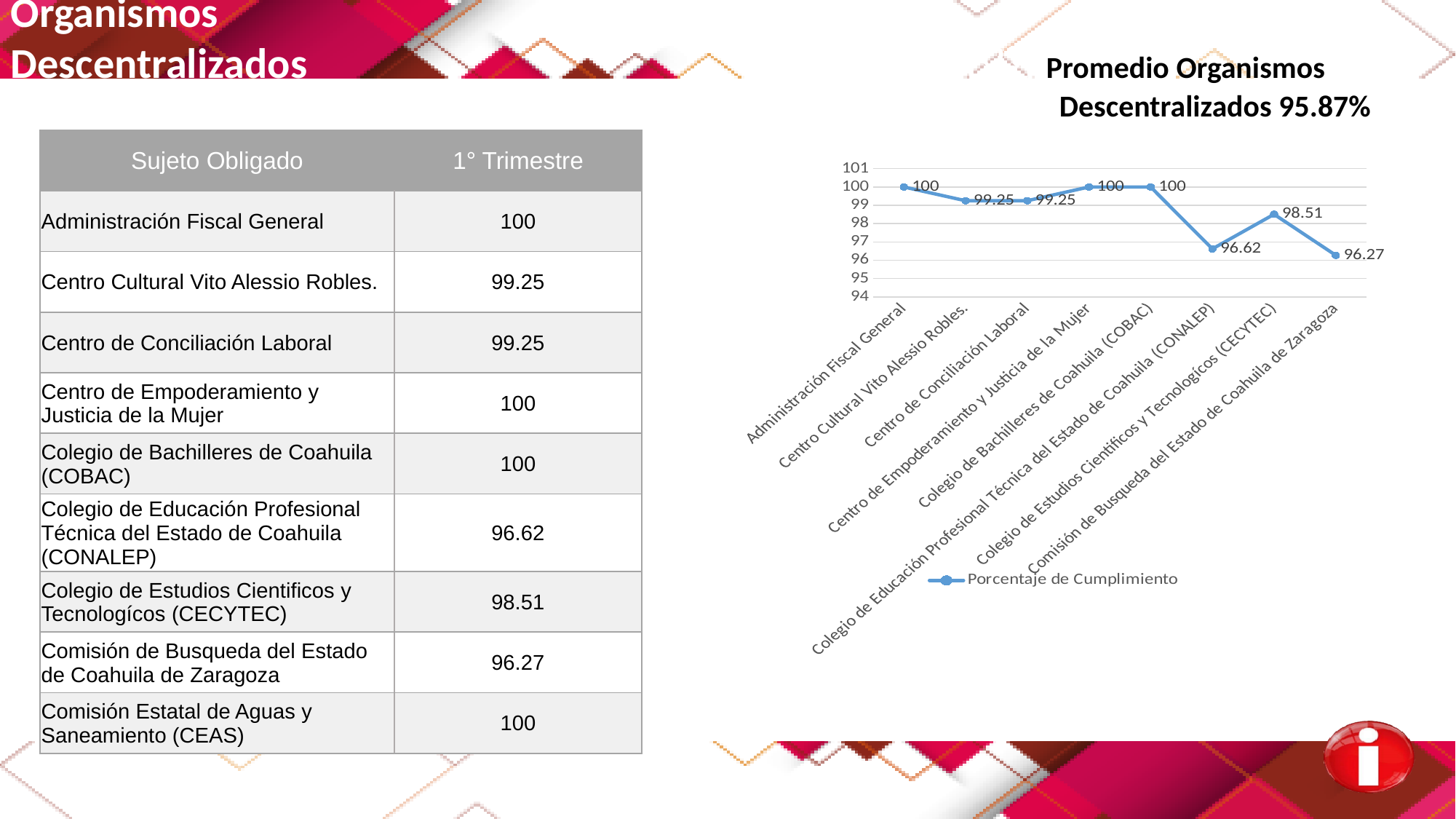
Is the value for CONALEP greater or less than 98? less What kind of chart is shown on the slide? line chart What is the name of the series shown in the chart legend? Porcentaje de Cumplimiento Which is larger, the value for Centro de Conciliación Laboral or the value for Comisión de Busqueda del Estado de Coahuila de Zaragoza? Centro de Conciliación Laboral How many data points are plotted on the line chart? 8 What is the difference between the values for CECYTEC and CONALEP? 1.89 What is the plotted value for Centro Cultural Vito Alessio Robles? 99.25 What is the plotted value for Colegio de Educación Profesional Técnica del Estado de Coahuila (CONALEP)? 96.62 Does the line rise or fall between Colegio de Bachilleres de Coahuila (COBAC) and CONALEP? fall How many series does the chart legend list? 1 Which category has the lowest value in the chart? Comisión de Busqueda del Estado de Coahuila de Zaragoza What is the plotted value for Colegio de Estudios Cientificos y Tecnologícos (CECYTEC)? 98.51